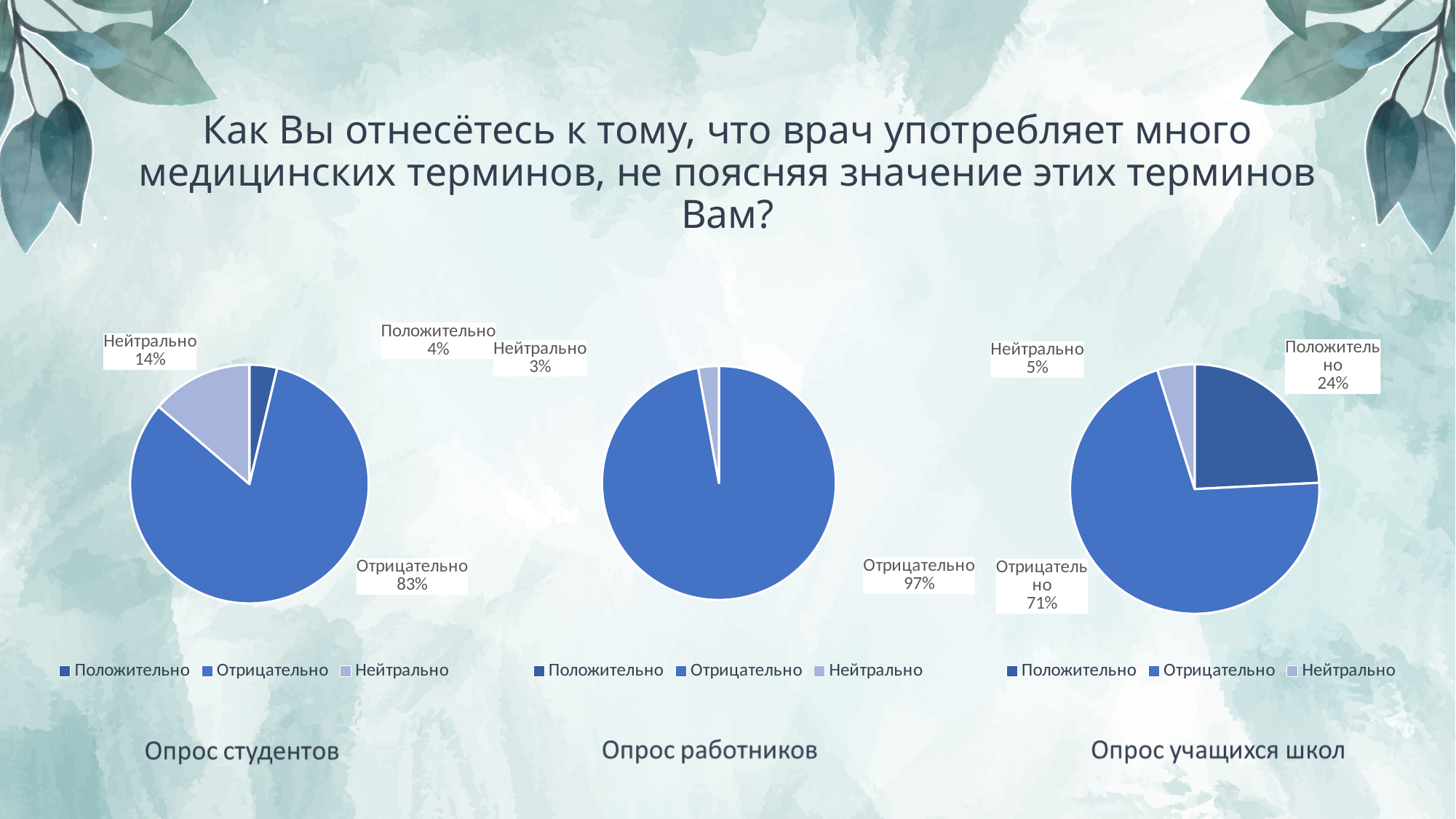
In the "Опрос студентов" pie chart, what share of respondents answered "Нейтрально"? 14% Which is larger: the "Нейтрально" share in the "Опрос студентов" chart or the "Нейтрально" share in the "Опрос учащихся школ" chart? Опрос студентов What type of chart is used for "Опрос работников"? Pie chart In the "Опрос учащихся школ" pie chart, what is the difference between the "Отрицательно" and "Положительно" shares? 47% In the "Опрос студентов" pie chart, which answer has the largest share? Отрицательно In the "Опрос студентов" pie chart, what share of respondents answered "Положительно"? 4% In the "Опрос учащихся школ" pie chart, which answer has the smallest share? Нейтрально In the "Опрос работников" pie chart, what share of respondents answered "Отрицательно"? 97% In the "Опрос учащихся школ" pie chart, what share of respondents answered "Положительно"? 24% In the "Опрос учащихся школ" pie chart, what share of respondents answered "Отрицательно"? 71% In the "Опрос студентов" pie chart, what share of respondents answered "Отрицательно"? 83% In the "Опрос работников" pie chart, what share of respondents answered "Нейтрально"? 3%